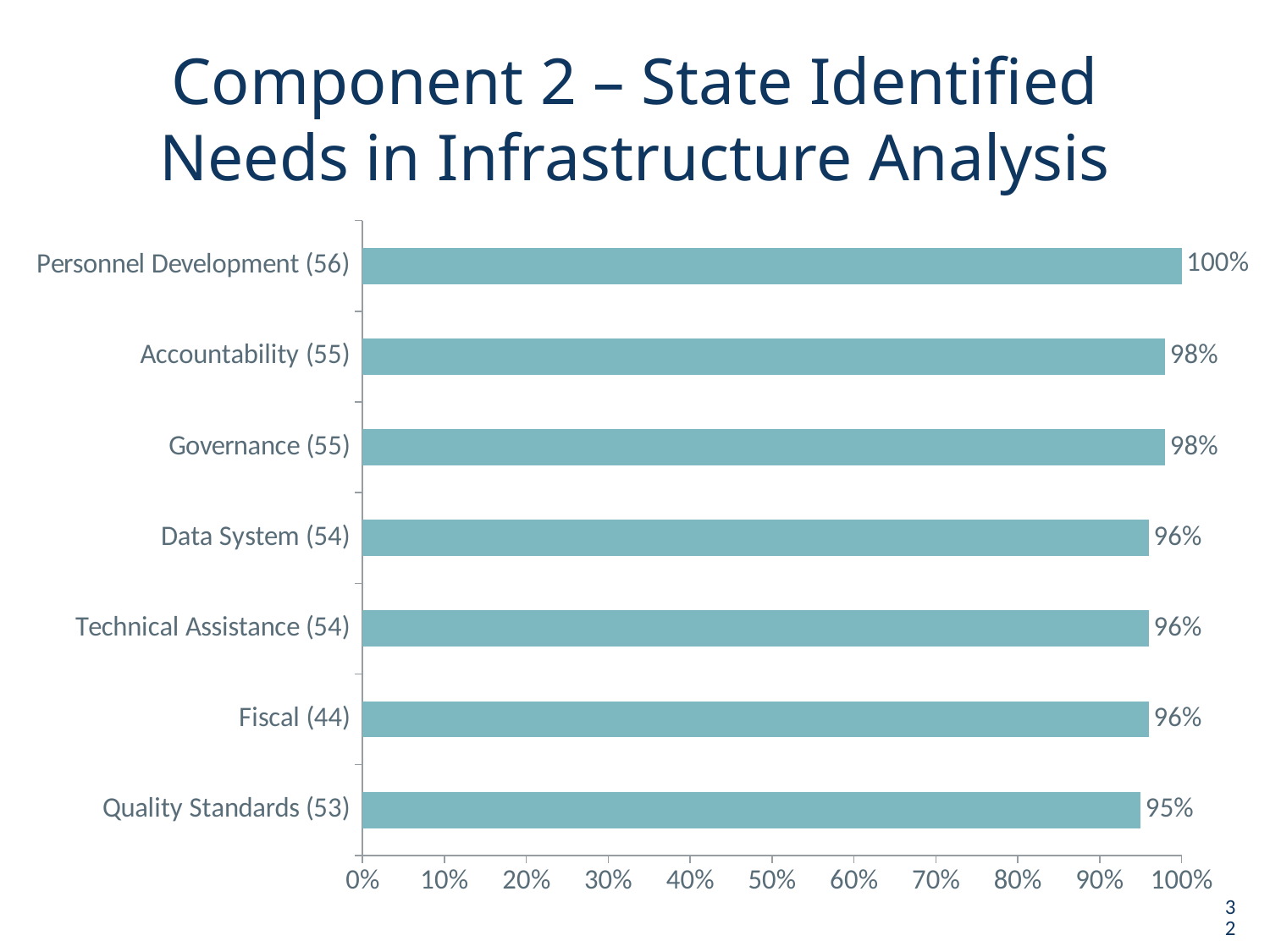
Which category has the lowest value? Quality Standards (53) Is the value for Data System (54) greater or less than 90%? greater What is the value for Governance (55)? 98% What is the value for Quality Standards (53)? 95% What is the difference between the values for Personnel Development (56) and Quality Standards (53)? 5% Which category has the highest value? Personnel Development (56) What kind of chart is shown on the slide? Bar chart Which is larger, the value for Accountability (55) or the value for Technical Assistance (54)? Accountability (55) What is the value for Fiscal (44)? 96% How many categories are shown in the chart? 7 What is the difference between the values for Accountability (55) and Data System (54)? 2% What is the value for Personnel Development (56)? 100%